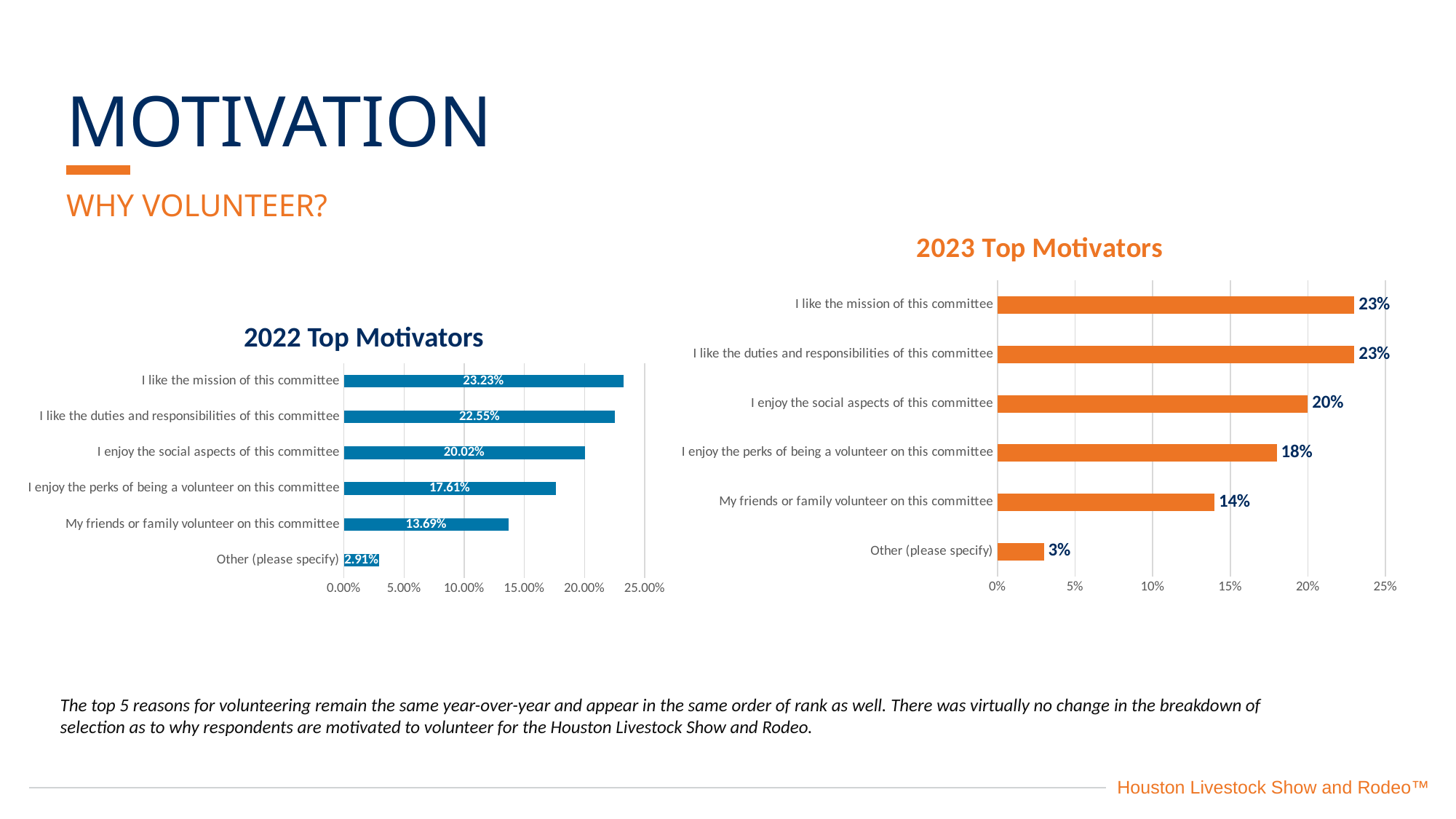
In the 2022 Top Motivators chart, what is the value for 'I like the mission of this committee'? 23.23% In the 2022 Top Motivators chart, what is the value for 'My friends or family volunteer on this committee'? 13.69% In the 2022 Top Motivators chart, which is larger: 'I like the duties and responsibilities of this committee' or 'I enjoy the social aspects of this committee'? I like the duties and responsibilities of this committee In the 2023 Top Motivators chart, what is the difference between 'I enjoy the social aspects of this committee' and 'My friends or family volunteer on this committee'? 6% In the 2023 Top Motivators chart, what is the value for 'Other (please specify)'? 3% How many categories are shown in the 2023 Top Motivators chart? 6 In the 2022 Top Motivators chart, what is the difference between 'I enjoy the social aspects of this committee' and 'I enjoy the perks of being a volunteer on this committee'? 2.41% What type of chart is the 2022 Top Motivators chart? Bar chart In the 2022 Top Motivators chart, which category has the highest value? I like the mission of this committee In the 2023 Top Motivators chart, which category has the lowest value? Other (please specify) What colour are the bars in the 2023 Top Motivators chart? Orange In the 2023 Top Motivators chart, what is the value for 'I enjoy the perks of being a volunteer on this committee'? 18%